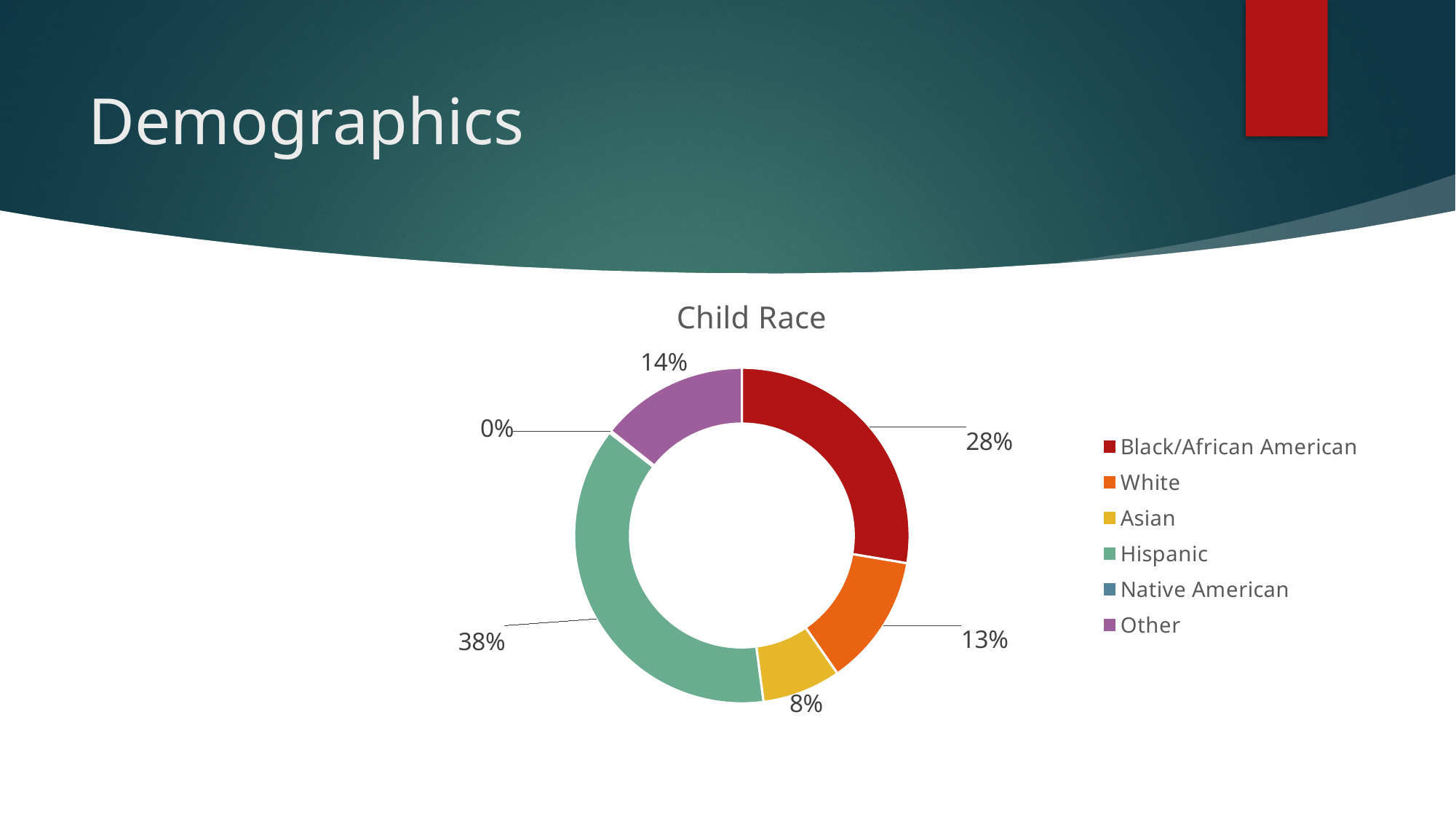
Which category has the largest share in the Child Race chart? Hispanic What share of the Child Race chart is Asian? 8% Which is larger in the Child Race chart, the White share or the Other share? Other What share of the Child Race chart is Black/African American? 28% What share of the Child Race chart is White? 13% What share of the Child Race chart is Hispanic? 38% What share of the Child Race chart is Other? 14% What share of the Child Race chart is Native American? 0% What is the difference between the Hispanic and Black/African American shares in the Child Race chart? 10% Which category has the smallest share in the Child Race chart? Native American What kind of chart is the Child Race chart? Pie chart (doughnut) How many categories does the legend of the Child Race chart list? 6